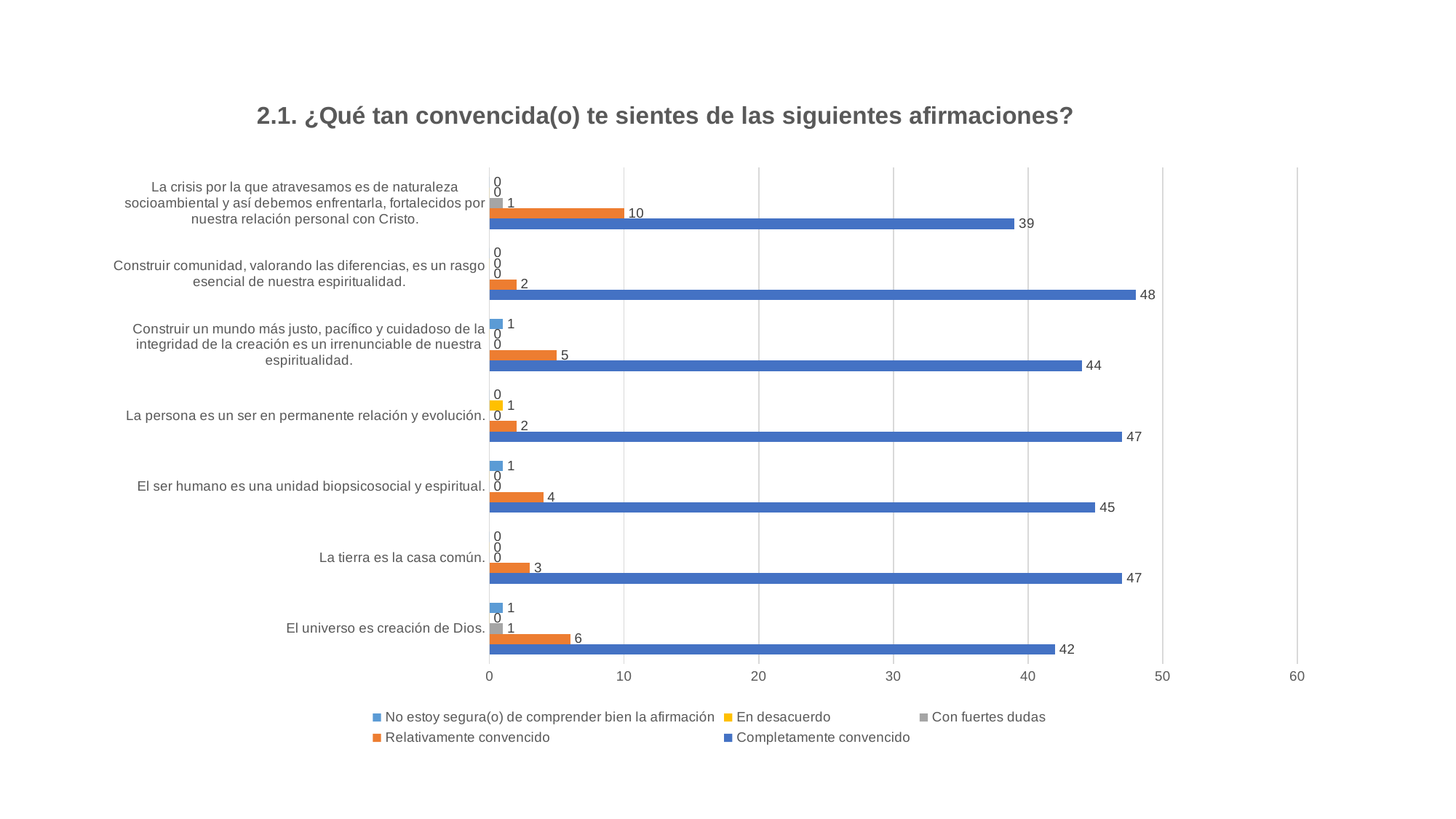
What is the value of 'Completamente convencido' for 'La tierra es la casa común.'? 47 What is the value of 'Relativamente convencido' for 'El universo es creación de Dios.'? 6 How many series does the legend list? 5 Is the 'Completamente convencido' value for 'El ser humano es una unidad biopsicosocial y espiritual.' greater or less than 40? greater Which is larger: the 'Relativamente convencido' value for 'La crisis por la que atravesamos...' or for 'El universo es creación de Dios.'? La crisis por la que atravesamos... Which statement has the lowest 'Completamente convencido' value? La crisis por la que atravesamos es de naturaleza socioambiental y así debemos enfrentarla, fortalecidos por nuestra relación personal con Cristo. How many statements (categories) are plotted on the chart? 7 What is the difference between the 'Completamente convencido' values for 'Construir comunidad...' (48) and 'La crisis por la que atravesamos...' (39)? 9 Which statement has the highest 'Completamente convencido' value? Construir comunidad, valorando las diferencias, es un rasgo esencial de nuestra espiritualidad. What is the 'En desacuerdo' value for 'La persona es un ser en permanente relación y evolución.'? 1 What kind of chart is shown on the slide? bar chart What is the title of the chart? 2.1. ¿Qué tan convencida(o) te sientes de las siguientes afirmaciones?